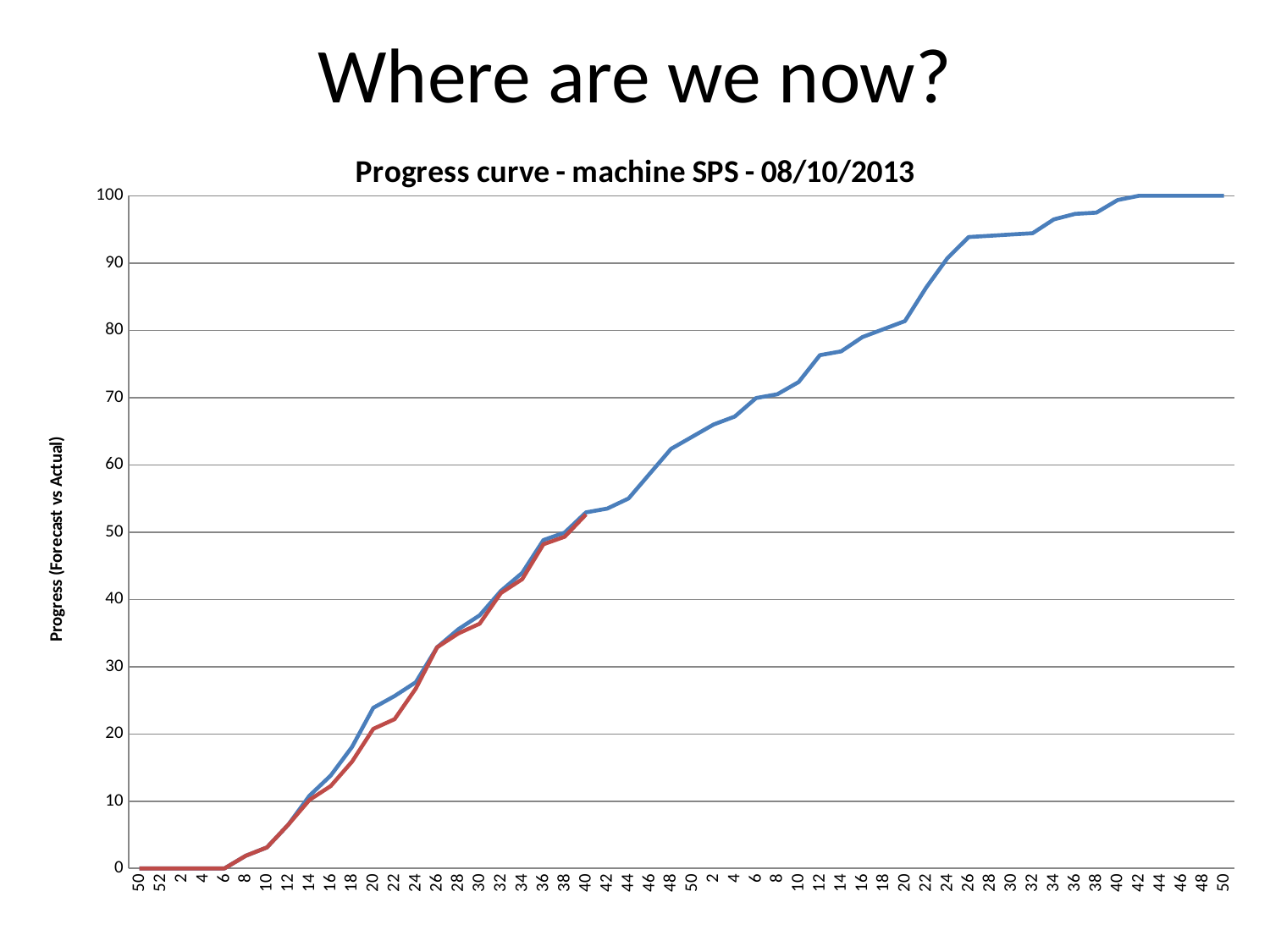
What value does the blue line reach at the right-hand end of the chart (x label 50)? 100 What is the label on the vertical axis of the chart? Progress (Forecast vs Actual) What type of chart is shown on the slide? line chart At which x-axis label does the red line end? 40 At the first x-axis label 20, which line has the higher value, the blue line or the red line? blue line Do the plotted values rise or fall along the x axis? rise Is the value of the blue line at the second x-axis label 12 greater or less than 70? greater How many lines are plotted on the chart? 2 What is the title of the chart? Progress curve - machine SPS - 08/10/2013 What is the value of the lines at the first x-axis label (50) on the left? 0 Is the value of the red line at the first x-axis label 10 greater or less than 10? less Is the value of the blue line at the second x-axis label 26 greater or less than 90? greater